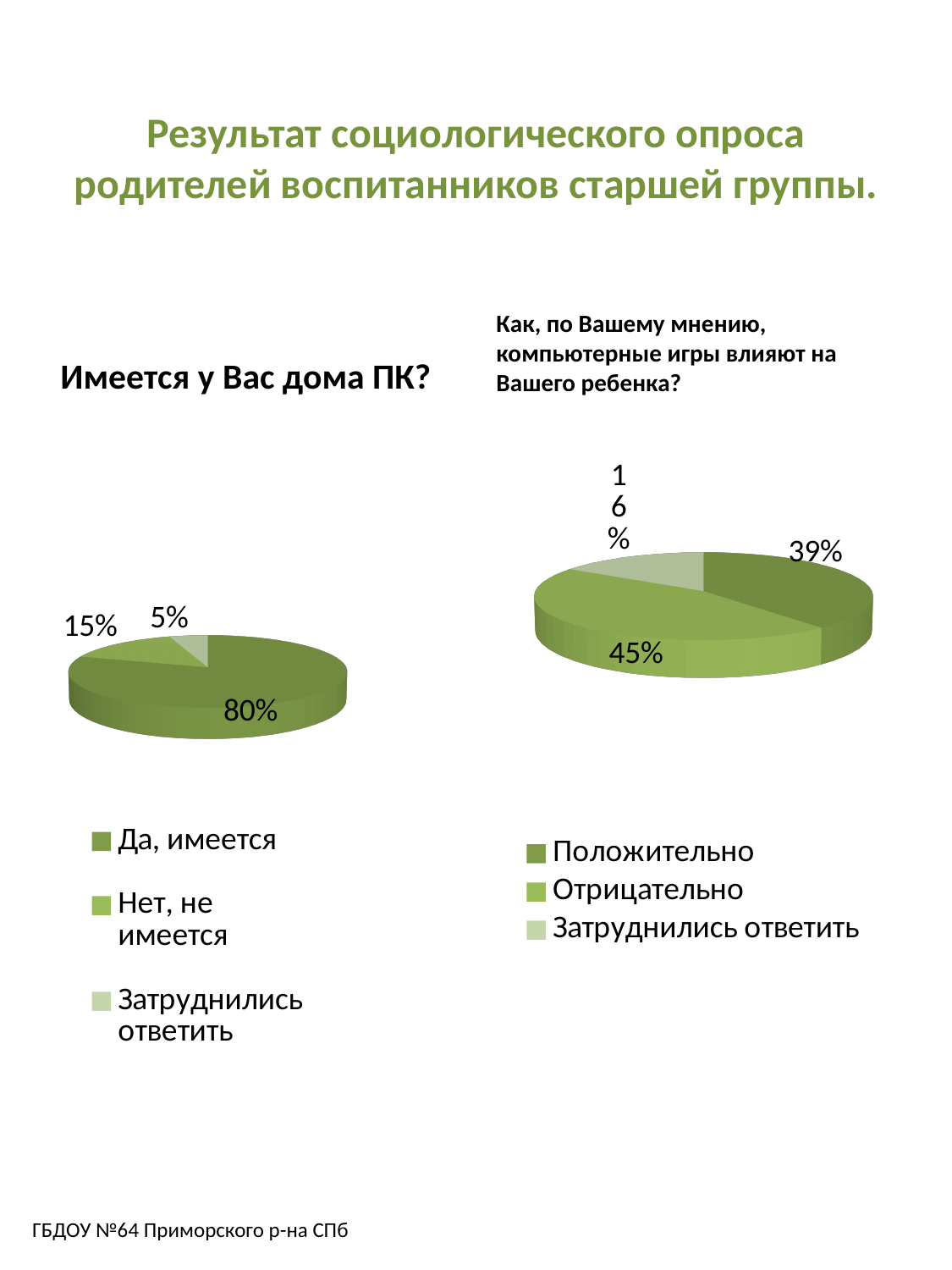
In the chart titled "Имеется у Вас дома ПК?", what share of respondents answered "Да, имеется"? 80% What type of chart is used for "Имеется у Вас дома ПК?"? Pie chart In the chart on the right ("Как, по Вашему мнению, компьютерные игры влияют на Вашего ребенка?"), what share of respondents answered "Затруднились ответить"? 16% How many slices does the chart titled "Имеется у Вас дома ПК?" have? 3 In the chart titled "Имеется у Вас дома ПК?", which answer has the largest share? Да, имеется In the chart titled "Имеется у Вас дома ПК?", what share of respondents answered "Затруднились ответить"? 5% In the chart on the right ("Как, по Вашему мнению, компьютерные игры влияют на Вашего ребенка?"), which is larger: the share for "Положительно" or for "Отрицательно"? Отрицательно In the chart on the right ("Как, по Вашему мнению, компьютерные игры влияют на Вашего ребенка?"), what share of respondents answered "Положительно"? 39% In the chart on the right ("Как, по Вашему мнению, компьютерные игры влияют на Вашего ребенка?"), what share of respondents answered "Отрицательно"? 45% In the chart titled "Имеется у Вас дома ПК?", what is the difference between the shares for "Да, имеется" and "Нет, не имеется"? 65% In the chart titled "Имеется у Вас дома ПК?", what share of respondents answered "Нет, не имеется"? 15% In the chart on the right ("Как, по Вашему мнению, компьютерные игры влияют на Вашего ребенка?"), which answer has the smallest share? Затруднились ответить